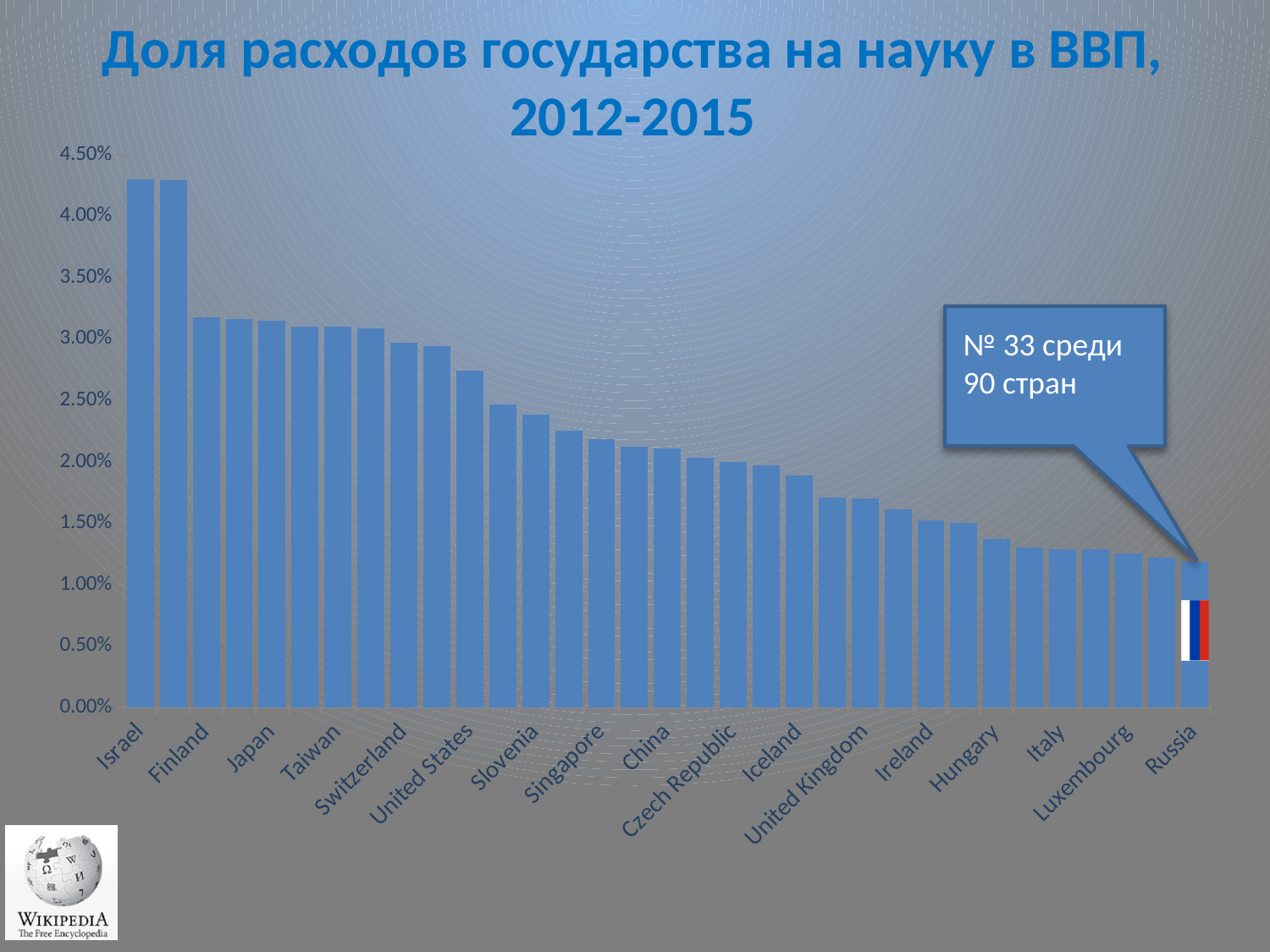
Is the value for Russia greater or less than 1.00%? greater Is the value for Israel greater or less than 4.00%? greater What kind of chart is shown on the slide? bar chart Is the value for United States greater or less than 3.00%? less Which has the larger value, Japan or United States? Japan How many bars (countries) are plotted in the chart? 33 What is the title of the chart? Доля расходов государства на науку в ВВП, 2012-2015 What does the callout pointing at the Russia bar say? № 33 среди 90 стран Do the values rise or fall moving from left to right along the x axis? fall Which has the larger value, China or Hungary? China